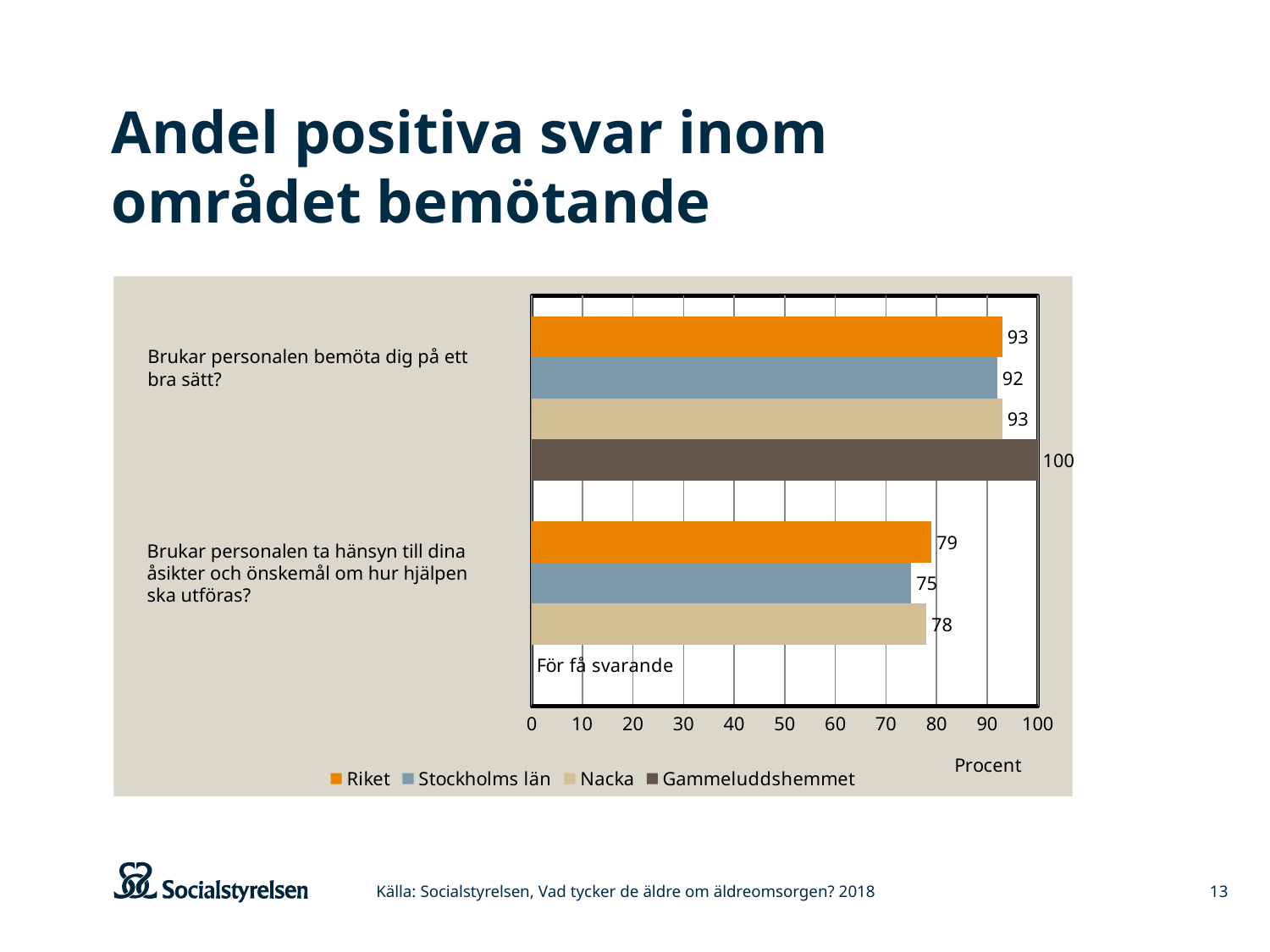
Which is larger on the question "Brukar personalen ta hänsyn till dina åsikter och önskemål om hur hjälpen ska utföras?": Riket or Nacka? Riket Which series has the highest value on the question "Brukar personalen bemöta dig på ett bra sätt?"? Gammeluddshemmet What is the difference between the Riket values for the two questions? 14 Which series has the lowest value on the question "Brukar personalen ta hänsyn till dina åsikter och önskemål om hur hjälpen ska utföras?"? Stockholms län What is the value for Gammeluddshemmet on the question "Brukar personalen bemöta dig på ett bra sätt?"? 100 How many series does the legend list? 4 What text is shown in place of the Gammeluddshemmet bar for the question "Brukar personalen ta hänsyn till dina åsikter och önskemål om hur hjälpen ska utföras?"? För få svarande What is the value for Riket on the question "Brukar personalen bemöta dig på ett bra sätt?"? 93 What is the value for Nacka on the question "Brukar personalen ta hänsyn till dina åsikter och önskemål om hur hjälpen ska utföras?"? 78 What kind of chart is shown on the slide? Bar chart What is the value for Stockholms län on the question "Brukar personalen ta hänsyn till dina åsikter och önskemål om hur hjälpen ska utföras?"? 75 What is the label of the horizontal axis? Procent